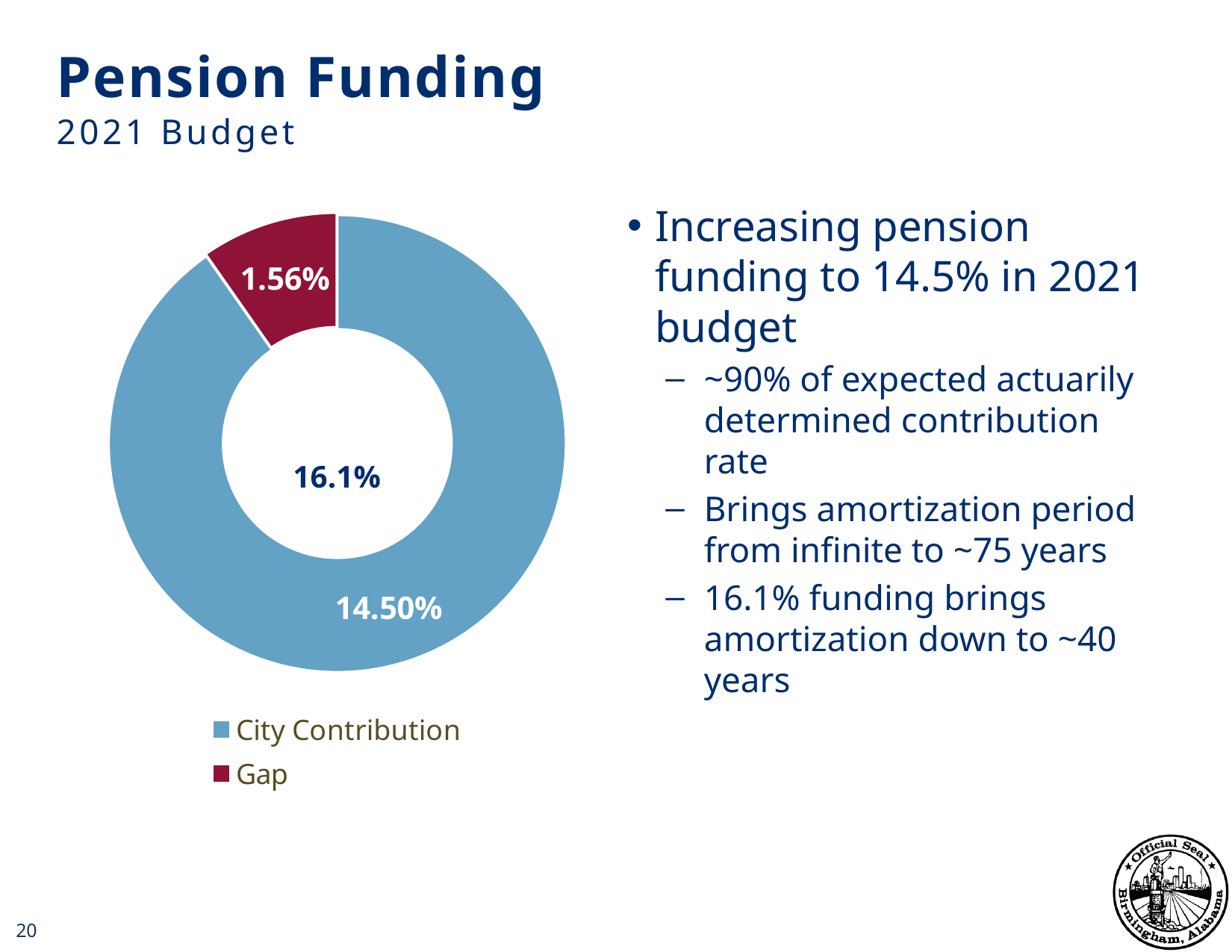
How many entries does the chart legend list? 2 Which is larger, City Contribution or Gap? City Contribution What is the value shown for City Contribution? 14.50% How many slices does the doughnut chart have? 2 What is the value shown for Gap? 1.56% Which slice of the doughnut chart is the largest? City Contribution What are the two legend entries of the chart? City Contribution and Gap What value is printed in the centre of the doughnut chart? 16.1% What kind of chart is shown on the slide? Doughnut chart Which slice of the doughnut chart is the smallest? Gap What colour is the Gap slice in the doughnut chart? Dark red What is the difference between the City Contribution value and the Gap value? 12.94%